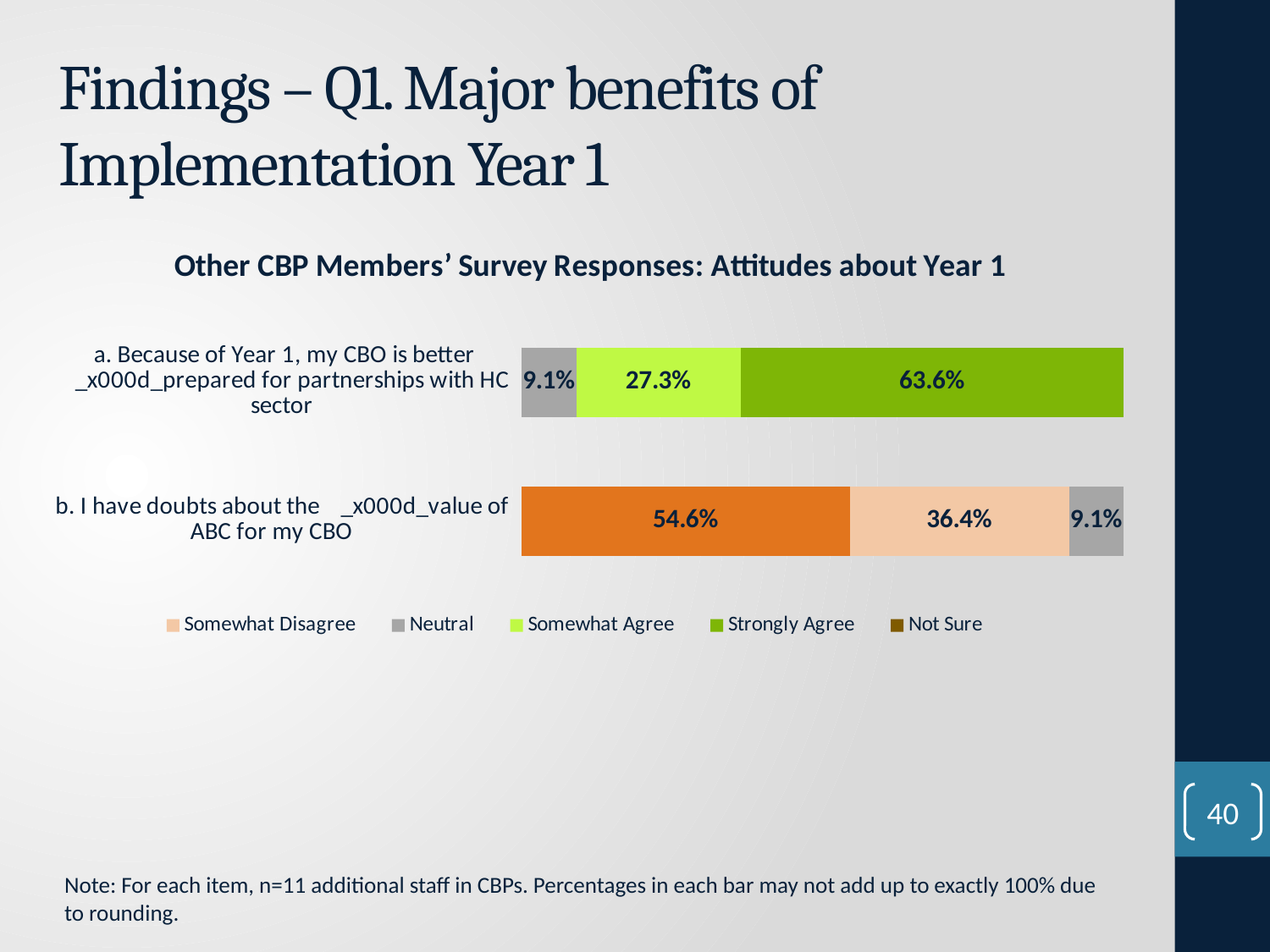
How many response categories does the legend list? 5 What percentage of respondents selected Strongly Agree for item a ("Because of Year 1, my CBO is better prepared for partnerships with HC sector")? 63.6% What is the value of the largest segment in the bar for item b? 54.6% Which is larger: the Strongly Agree share for item a or the Somewhat Disagree share for item b? Strongly Agree share for item a What is the title of the chart? Other CBP Members' Survey Responses: Attitudes about Year 1 What percentage of respondents selected Somewhat Disagree for item b ("I have doubts about the value of ABC for my CBO")? 36.4% What percentage of respondents were Neutral on item b? 9.1% What percentage of respondents selected Somewhat Agree for item a? 27.3% For item a, how much larger is the Strongly Agree share than the Somewhat Agree share? 36.3% What percentage of respondents were Neutral on item a? 9.1% What kind of chart is shown on the slide? Stacked bar chart How many survey items (bars) are shown in the chart? 2